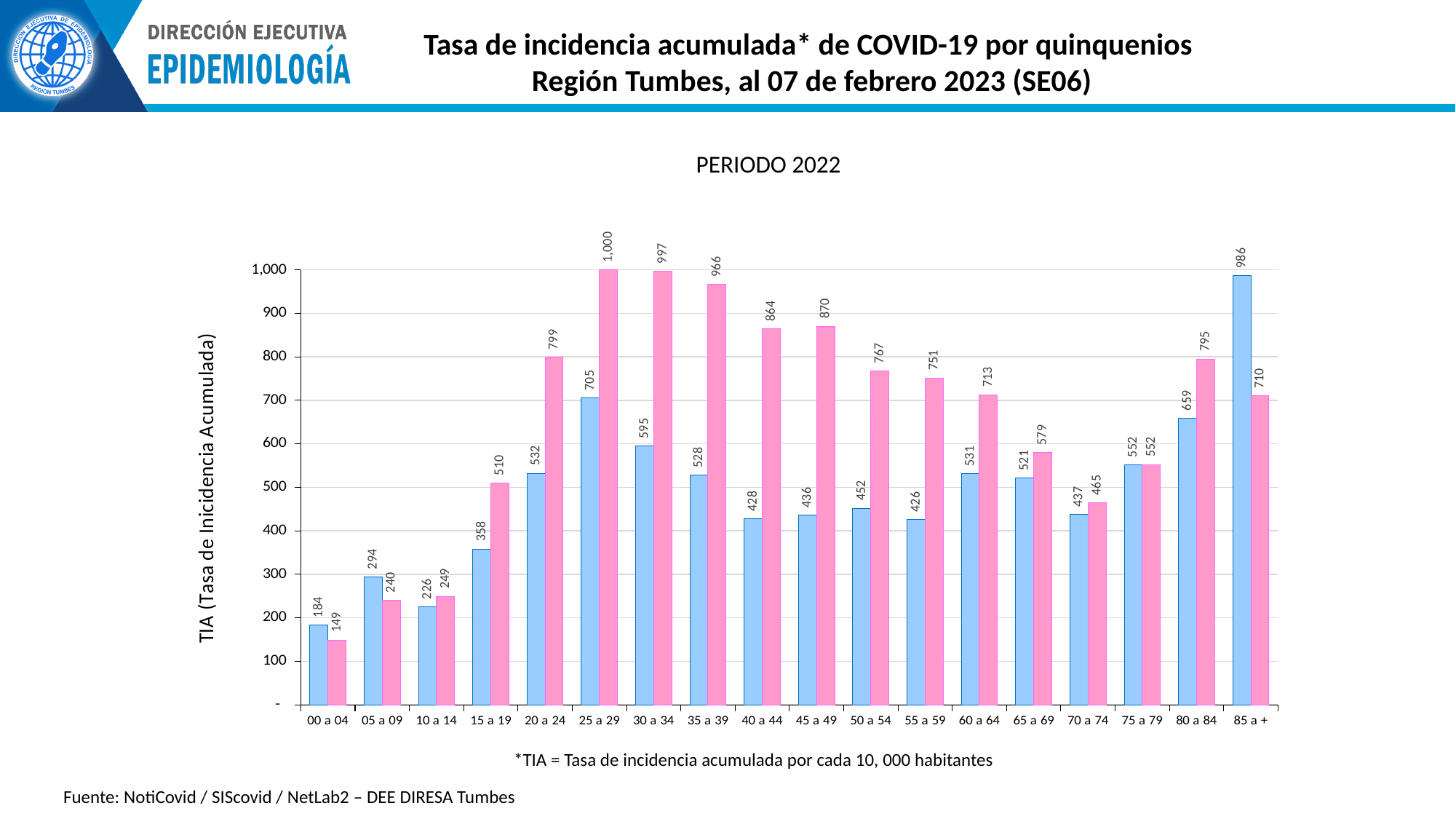
Which age group has the highest pink bar? 25 a 29 What is the difference between the pink and blue bars for the 30 a 34 age group? 402 Which age group has the highest blue bar? 85 a + What is the y-axis label of the chart? TIA (Tasa de Incidencia Acumulada) What is the title shown above the chart? PERIODO 2022 Which age group has the lowest blue bar? 00 a 04 For the 75 a 79 age group, what are the values of the blue and pink bars? 552 and 552 What is the value of the pink bar for the 85 a + age group? 710 What is the value of the blue bar for the 25 a 29 age group? 705 What kind of chart is shown on the slide? bar chart For the 00 a 04 age group, which bar is larger, blue or pink? blue How many age groups are shown on the x axis? 18